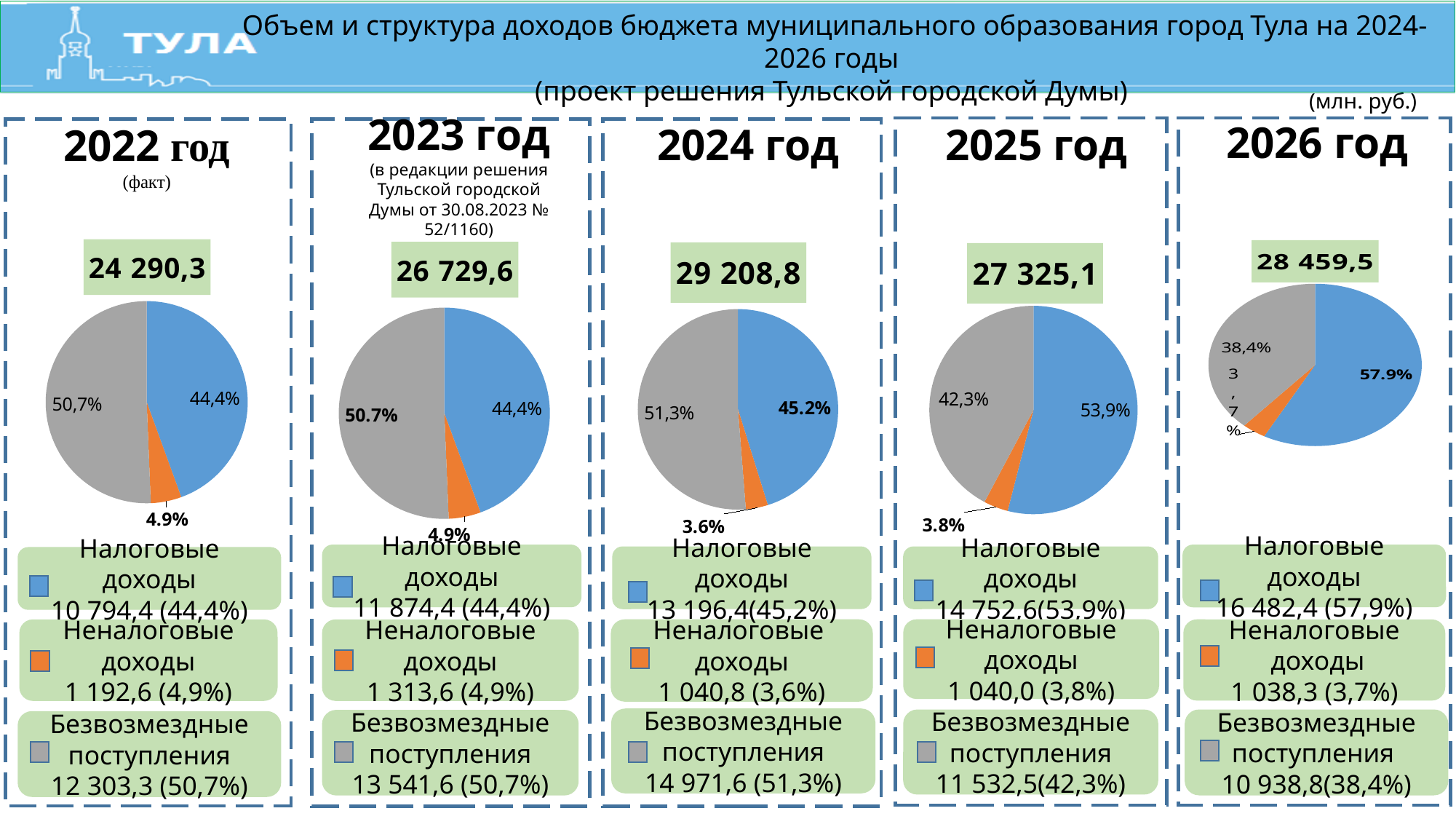
What total budget revenue (млн. руб.) is shown above the 2024 год pie chart? 29 208,8 In the 2024 год pie chart, which category has the smallest share? Неналоговые доходы In the 2025 год pie chart, which category has the largest share? Налоговые доходы In the 2026 год pie chart, what share do Безвозмездные поступления have? 38,4% How many slices does the 2023 год pie chart have? 3 In the 2022 год pie chart, what share do Безвозмездные поступления have? 50,7% What kind of chart is used for the 2024 год panel? pie chart In the 2024 год pie chart, what share do Налоговые доходы have? 45,2% In the 2023 год panel, what is the value of Налоговые доходы in млн. руб.? 11 874,4 In the 2022 год pie chart, which is larger: Налоговые доходы or Безвозмездные поступления? Безвозмездные поступления In the 2026 год panel, what is the value of Неналоговые доходы in млн. руб.? 1 038,3